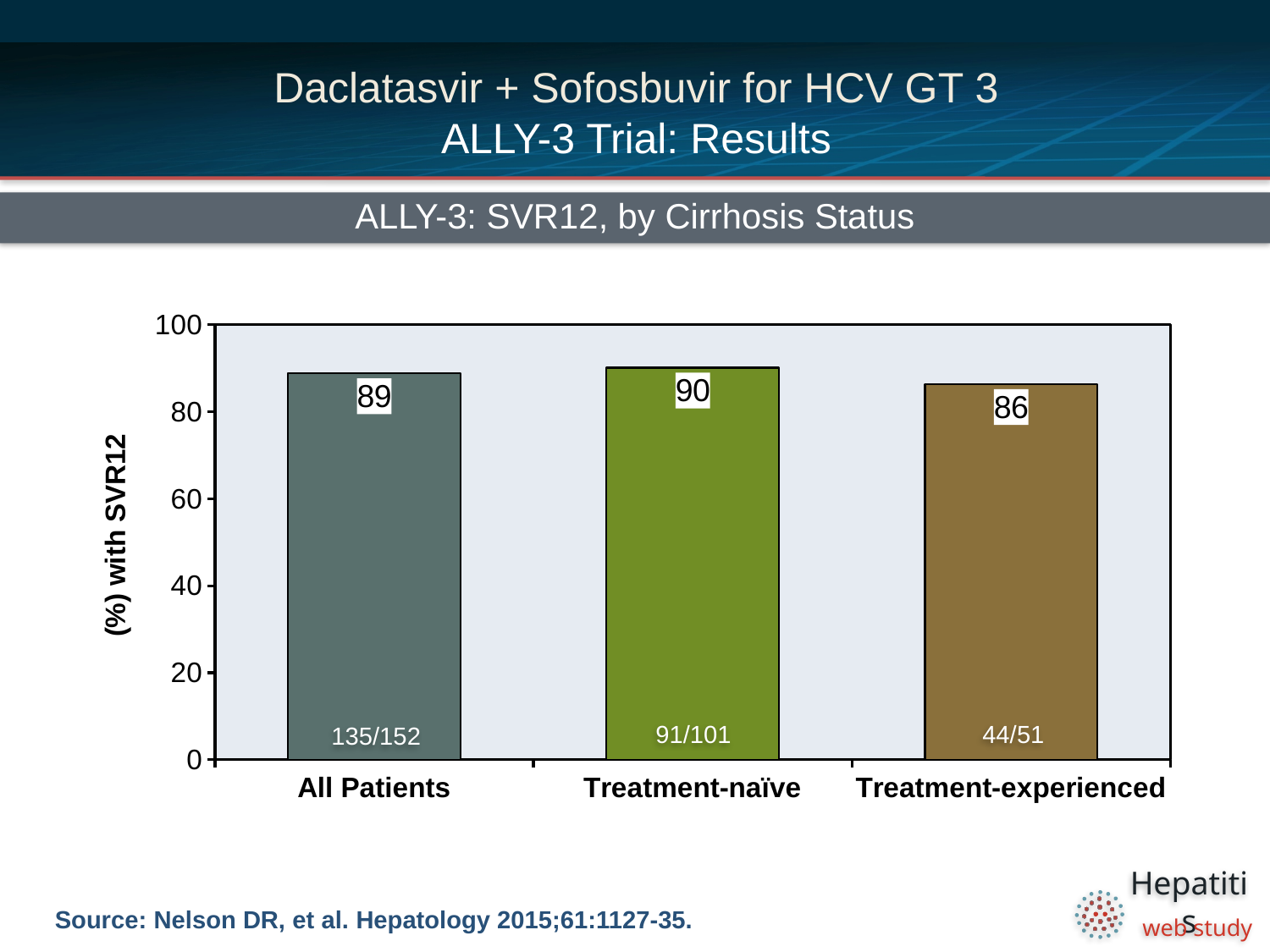
What is the title of the chart? ALLY-3: SVR12, by Cirrhosis Status How many categories are shown on the x axis? 3 What kind of chart is shown on the slide? bar chart What is the difference between the SVR12 values for Treatment-naïve and Treatment-experienced patients? 4 What is the SVR12 value for Treatment-naïve patients? 90 What fraction is printed at the bottom of the Treatment-naïve bar? 91/101 What is the SVR12 value for All Patients? 89 What is the SVR12 value for Treatment-experienced patients? 86 Which category has the highest SVR12 value? Treatment-naïve Is the SVR12 value for Treatment-experienced patients greater or less than 80? greater Which category has the lowest SVR12 value? Treatment-experienced Which is larger, the SVR12 value for All Patients or for Treatment-experienced patients? All Patients